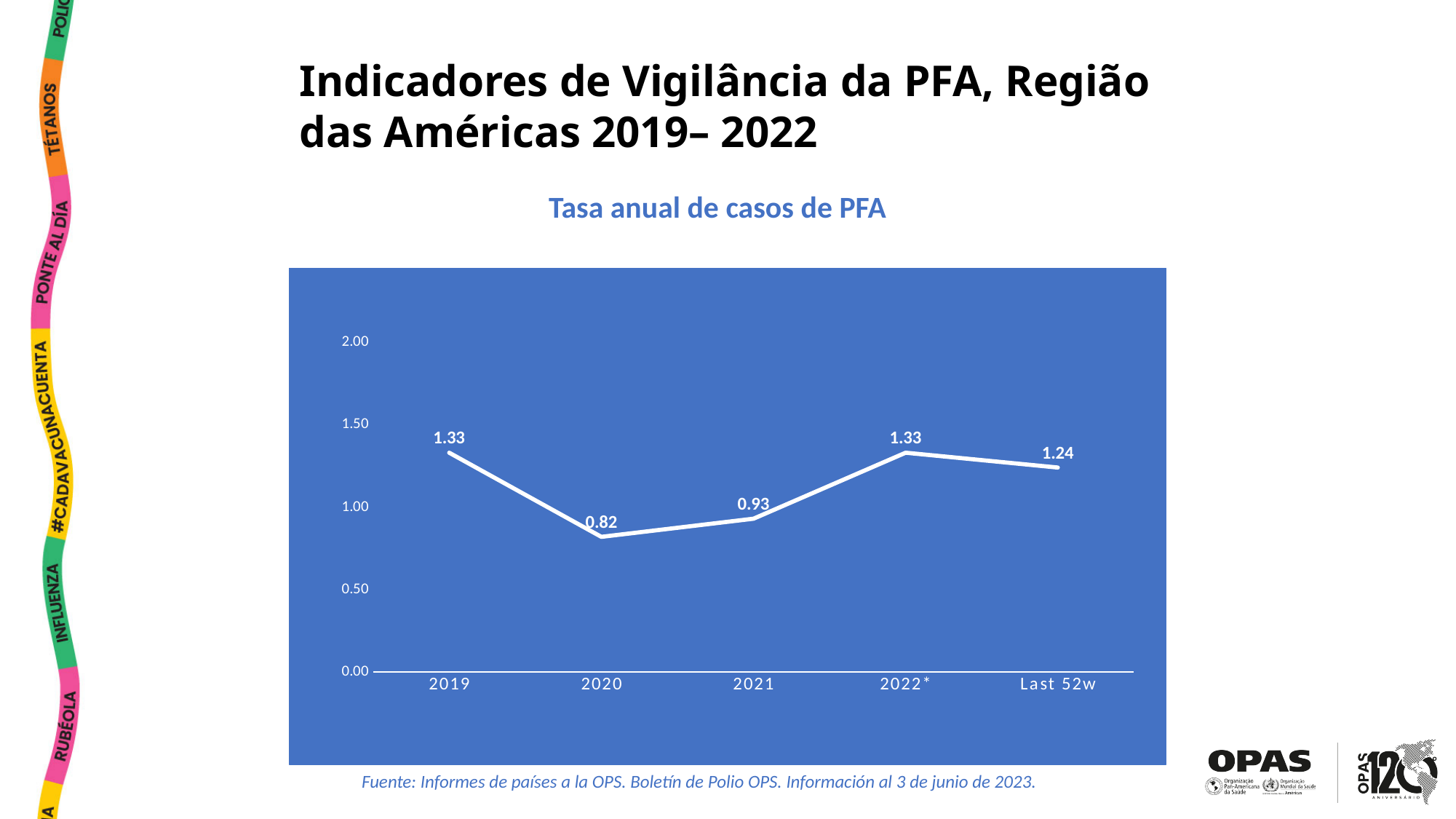
Which is larger, the value for 2021 or the value for Last 52w? Last 52w What is the annual PFA case rate for 2021? 0.93 What is the difference between the values for 2022* and Last 52w? 0.09 Is the value for 2020 greater or less than 1.00? less How many points are plotted along the x axis? 5 Which point on the x axis has the lowest value? 2020 Does the value rise or fall from 2020 to 2022*? rise What kind of chart is shown on the slide? line chart What is the difference between the values for 2019 and 2020? 0.51 What is the annual PFA case rate for 2020? 0.82 What is the value shown for 2022*? 1.33 What is the value shown for Last 52w? 1.24